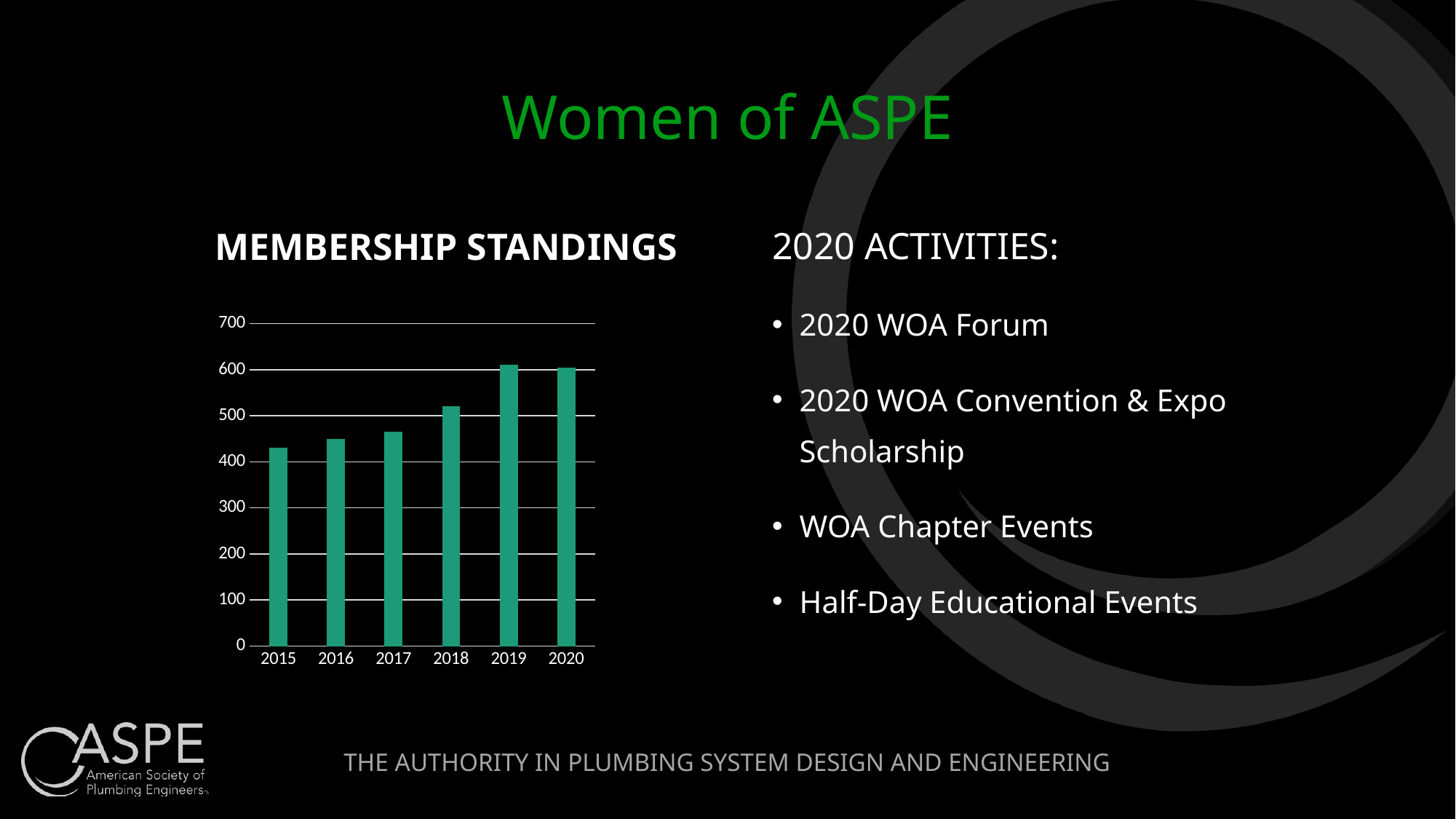
Is the value for 2019 greater or less than 600? greater Which year has the lowest bar in the MEMBERSHIP STANDINGS chart? 2015 What is the title of the chart on the slide? MEMBERSHIP STANDINGS Is the value for 2015 greater or less than 500? less Is the value for 2018 greater or less than 500? greater Which is larger, the value for 2019 or the value for 2017? 2019 What kind of chart is shown under MEMBERSHIP STANDINGS? bar chart Which is larger, the value for 2018 or the value for 2015? 2018 Do the values generally rise or fall from 2015 to 2020? rise How many years are shown on the x axis of the MEMBERSHIP STANDINGS chart? 6